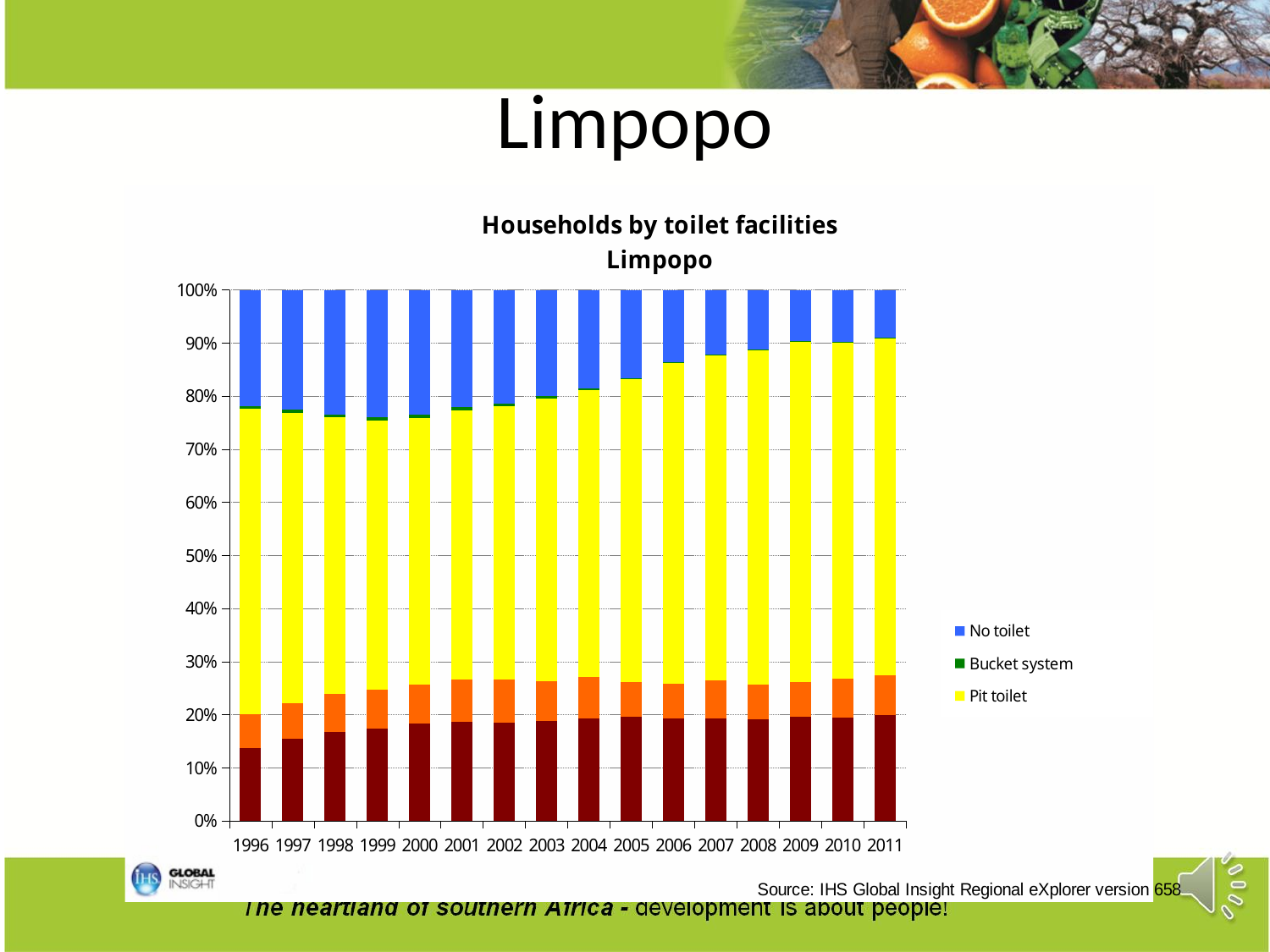
Is the No toilet share larger in 1996 or in 2011? 1996 Is the top of the Pit toilet segment in 1996 greater or less than 80%? less What is the title of the chart? Households by toilet facilities Limpopo Is the top of the Pit toilet segment in 2005 greater or less than 80%? greater Which colour represents Pit toilet in the legend? Yellow How many years are shown along the x axis of the chart? 16 Does the share of households with No toilet rise or fall from 1996 to 2011? Fall What type of chart is shown on the slide? Stacked bar chart What is the last year shown on the x axis? 2011 Is the top of the Pit toilet segment in 2006 greater or less than 90%? less Does the share of households with a Pit toilet rise or fall from 1996 to 2011? Rise What is the first year shown on the x axis? 1996